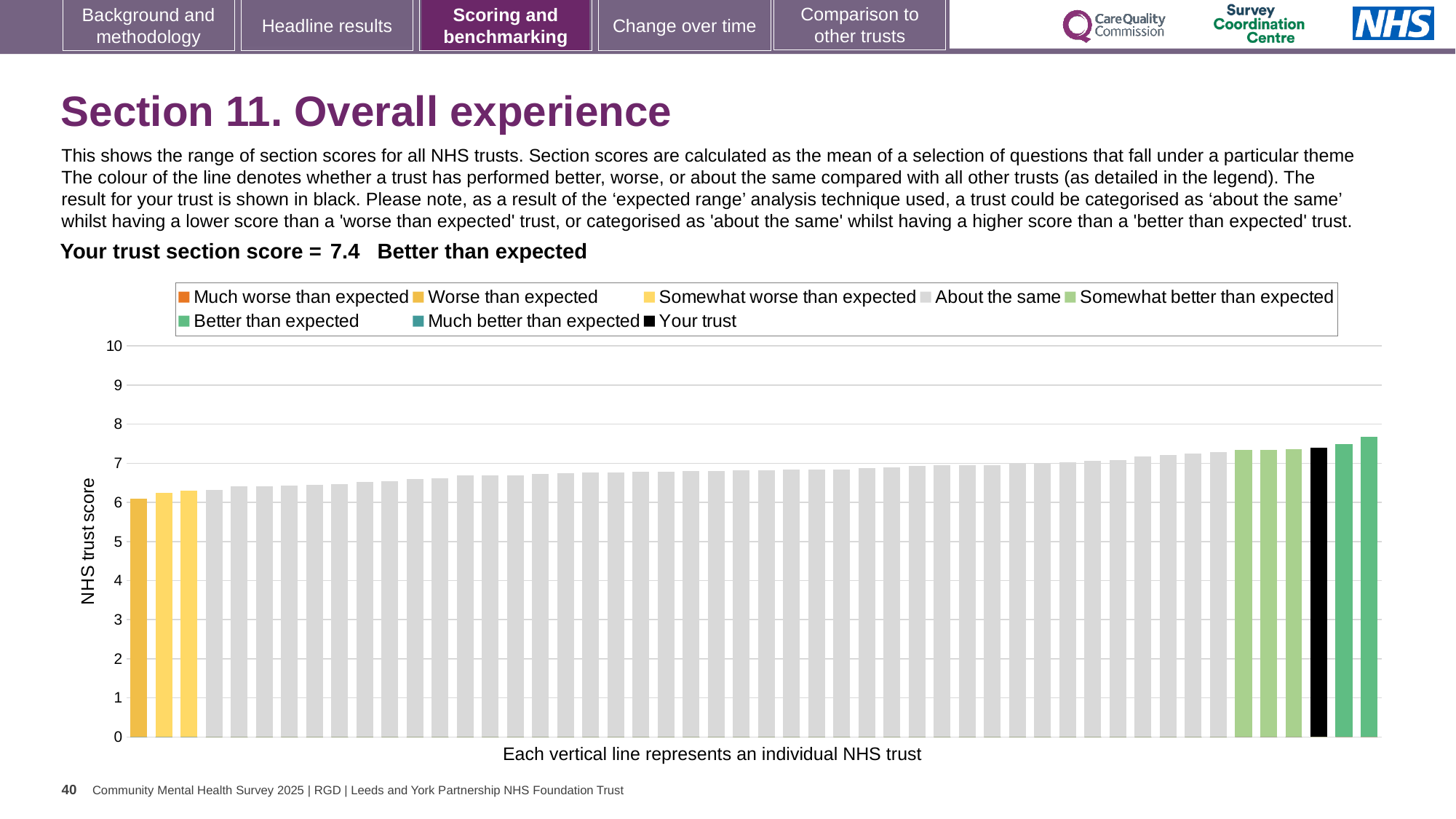
Is the value of the lowest bar (leftmost) greater or less than 7? less Do the bar values rise or fall from left to right along the x axis? rise What is the section score for your trust shown on the slide? 7.4 How many bars are coloured light green (somewhat better than expected)? 3 How many entries does the chart legend list? 8 What kind of chart is shown on the slide? bar chart Is the value for your trust (the black bar) greater or less than 7? greater What category is your trust's section score placed in, according to the text above the chart? Better than expected Is the value of the highest bar (rightmost) greater or less than 8? less What is the label on the y axis of the chart? NHS trust score How many bars are coloured yellow (worse or somewhat worse than expected)? 3 Which is larger: the rightmost bar or the black 'Your trust' bar? the rightmost bar